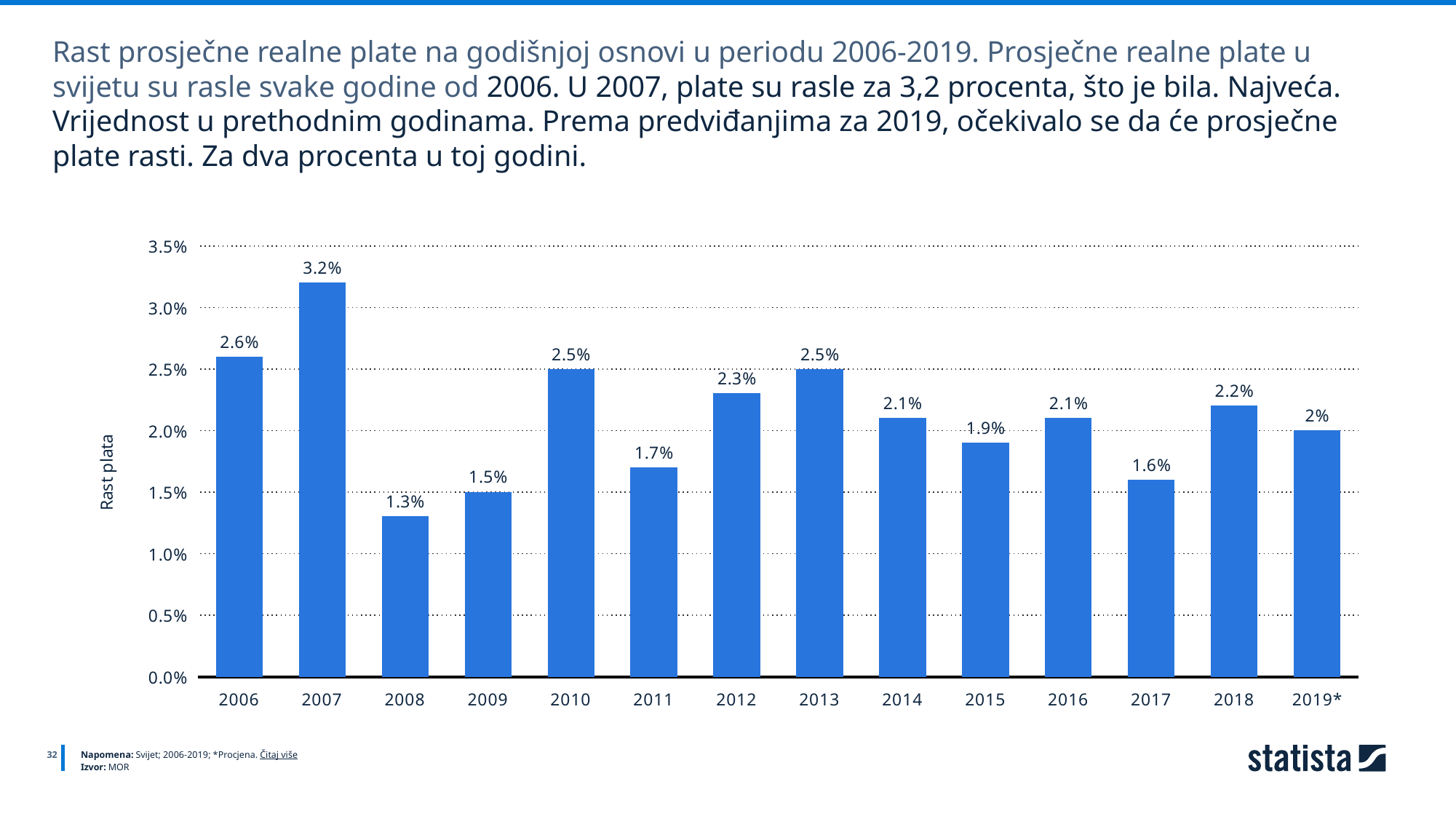
What is the label of the y axis? Rast plata What is the wage growth value for 2007? 3.2% Which year has higher wage growth, 2012 or 2017? 2012 Which year has the highest wage growth? 2007 What is the wage growth value for 2011? 1.7% What is the wage growth value for 2019*? 2% Do the values rise or fall from 2013 to 2015? fall How many years are shown on the x axis? 14 What kind of chart is shown on the slide? bar chart Which year has the lowest wage growth? 2008 Is the value for 2015 greater or less than 2.0%? less What is the difference between the wage growth in 2007 and 2008? 1.9%